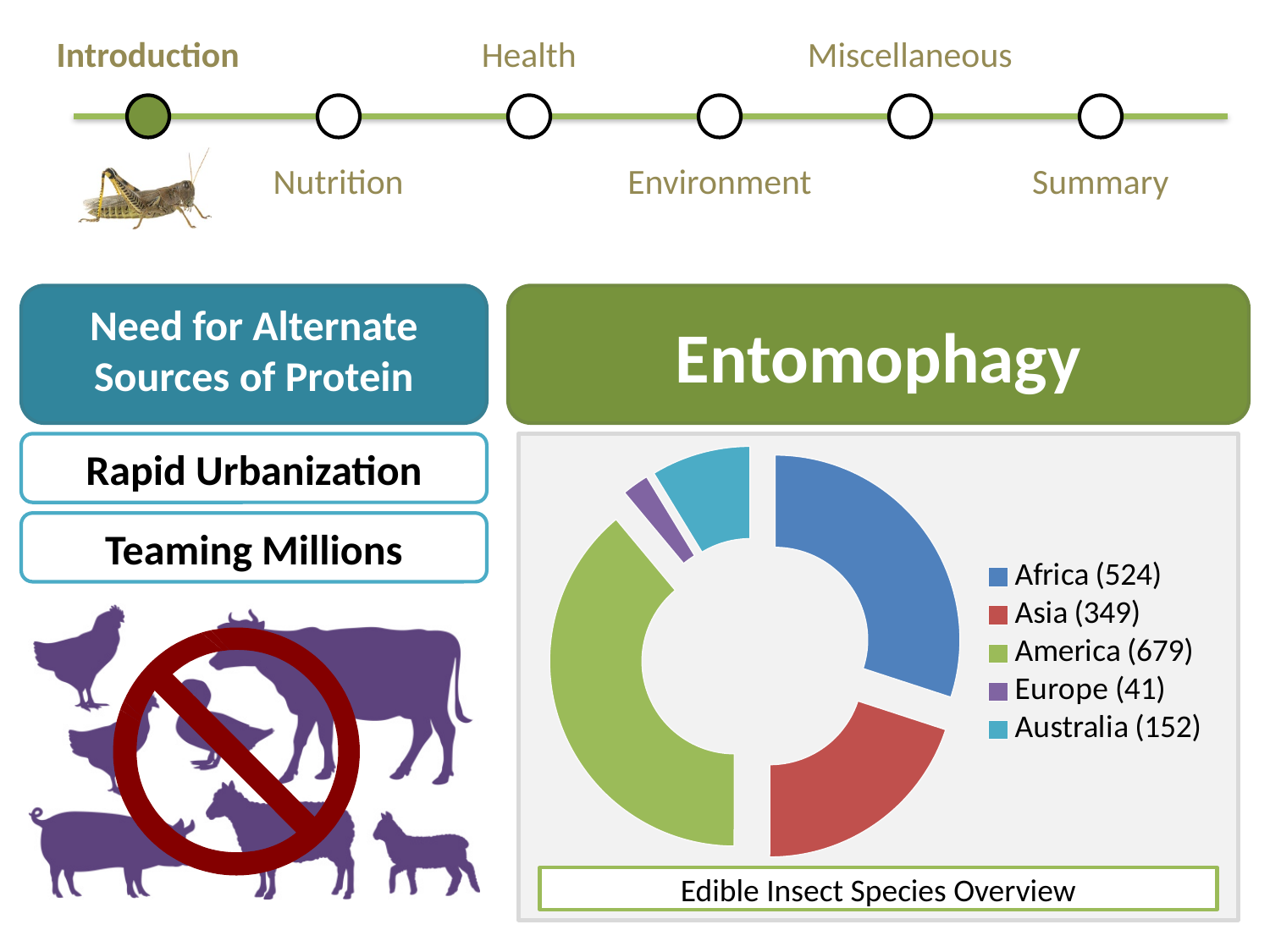
What is the caption shown below the doughnut chart? Edible Insect Species Overview How many regions are shown in the Edible Insect Species Overview chart? 5 What is the value for Australia in the Edible Insect Species Overview chart? 152 Which region has the lowest value in the Edible Insect Species Overview chart? Europe What is the value for Africa in the Edible Insect Species Overview chart? 524 Which is larger in the Edible Insect Species Overview chart, Asia or Australia? Asia What is the value for Asia in the Edible Insect Species Overview chart? 349 What is the value for Europe in the Edible Insect Species Overview chart? 41 Which region has the highest value in the Edible Insect Species Overview chart? America What is the difference between the values for America and Africa in the Edible Insect Species Overview chart? 155 What type of chart is shown under the Entomophagy heading? doughnut chart What is the total of all values in the Edible Insect Species Overview chart? 1745